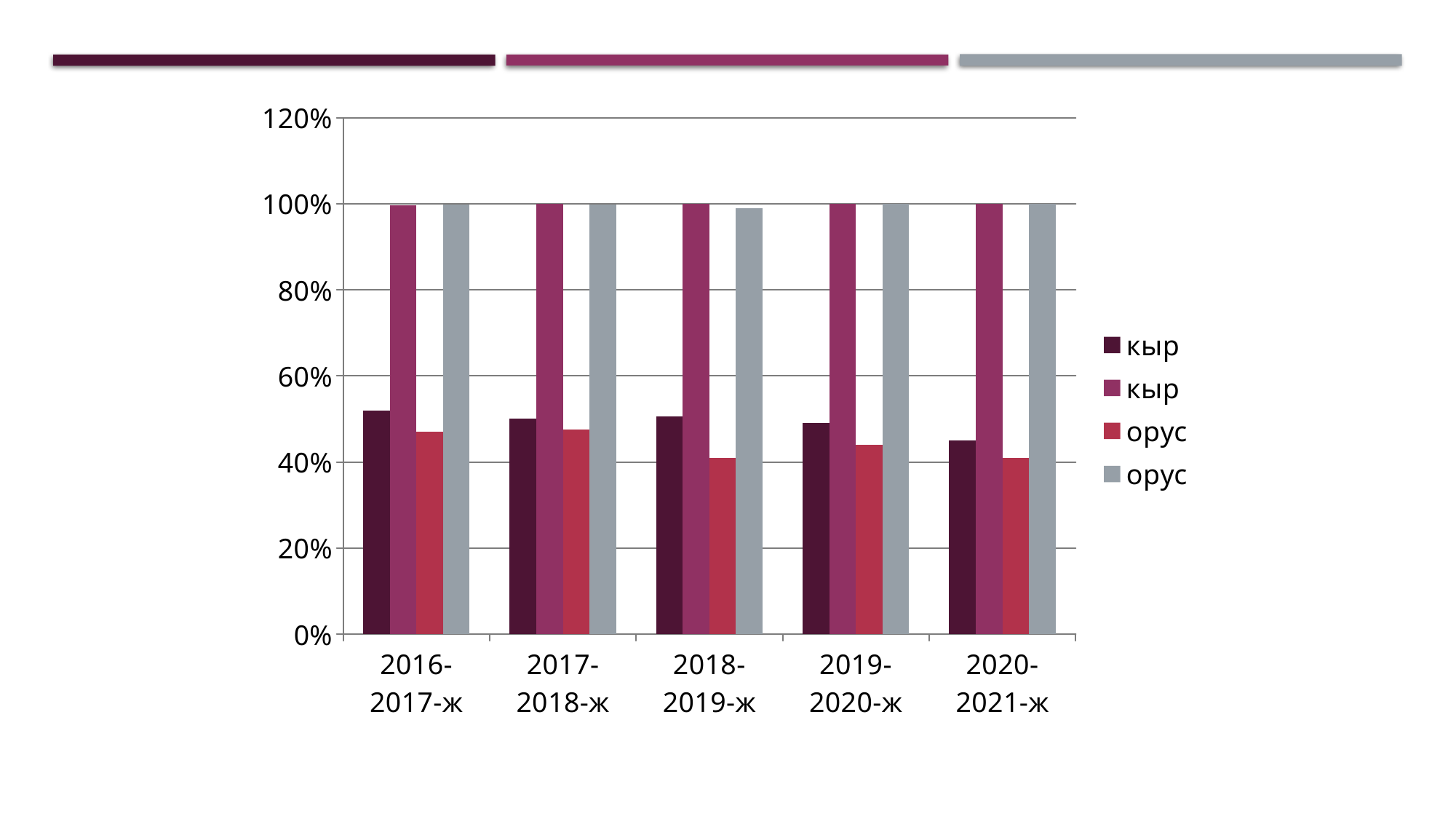
Among the dark purple bars, which category has the lowest value? 2020-2021-ж What is the highest value shown on the y axis? 120% Is the value of the red bar for 2018-2019-ж greater or less than 60%? less How many series does the legend list? 4 How many academic-year categories are shown on the x axis? 5 For 2018-2019-ж, which is larger: the dark purple bar or the red bar? the dark purple bar Is the value of the magenta bar for 2016-2017-ж greater or less than 80%? greater For 2019-2020-ж, which is larger: the magenta bar or the dark purple bar? the magenta bar Do the dark purple bars rise or fall overall from 2016-2017-ж to 2020-2021-ж? fall What kind of chart is shown on the slide? bar chart Is the value of the red bar for 2020-2021-ж greater or less than 60%? less